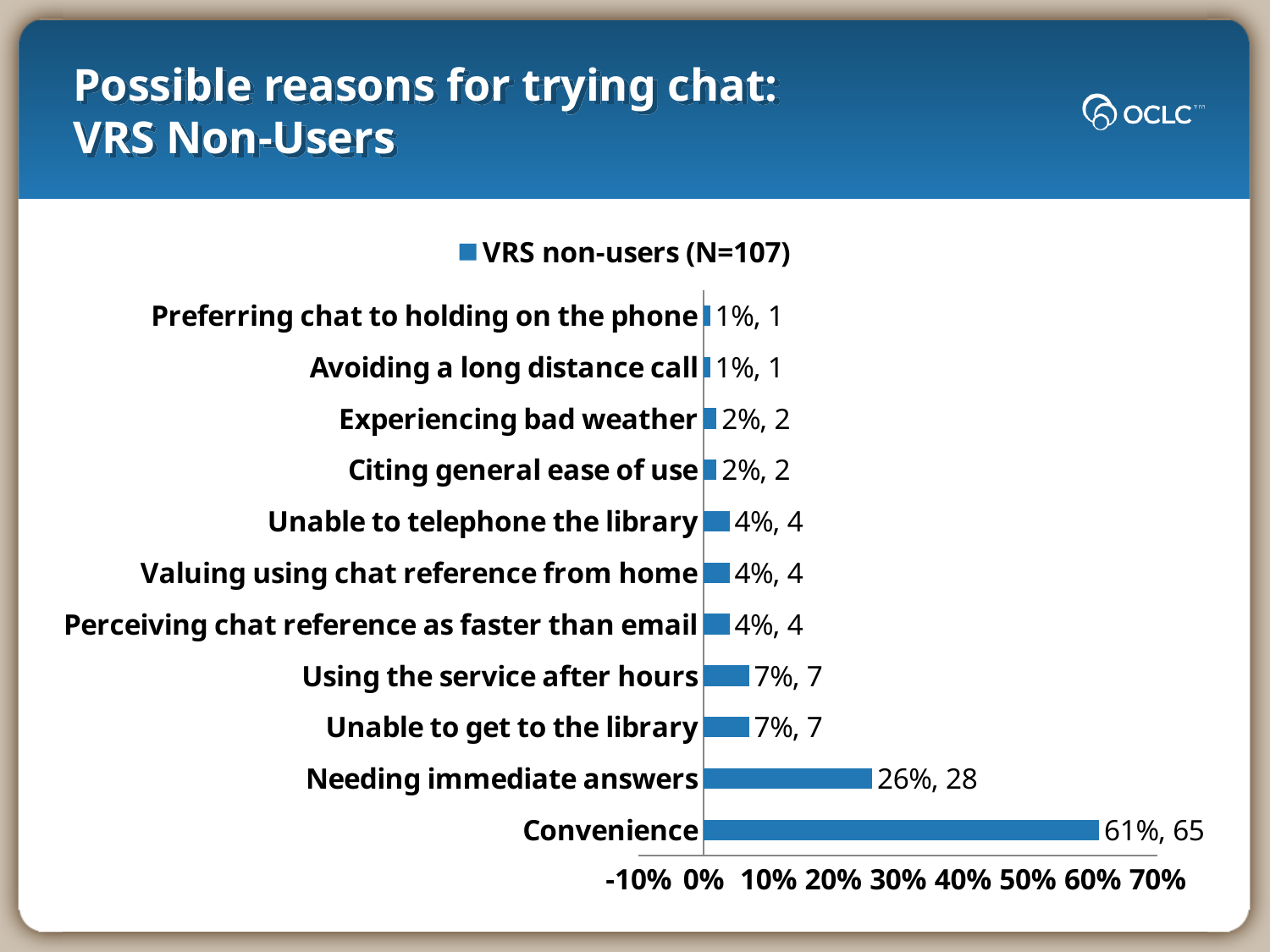
What is the difference in percentage points between Convenience and Needing immediate answers? 35 What kind of chart is shown on the slide? Bar chart How many VRS non-users cited Unable to telephone the library? 4 Which is larger, the value for Unable to get to the library or the value for Experiencing bad weather? Unable to get to the library How many reasons (categories) are plotted on the chart? 11 What is the sample size (N) given in the legend entry? 107 What percentage of VRS non-users cited Convenience as a reason for trying chat? 61% How many series does the legend list? 1 What percentage is shown for Using the service after hours? 7% Is the value for Convenience greater or less than 50%? greater How many VRS non-users cited Needing immediate answers? 28 Which reason has the highest value? Convenience